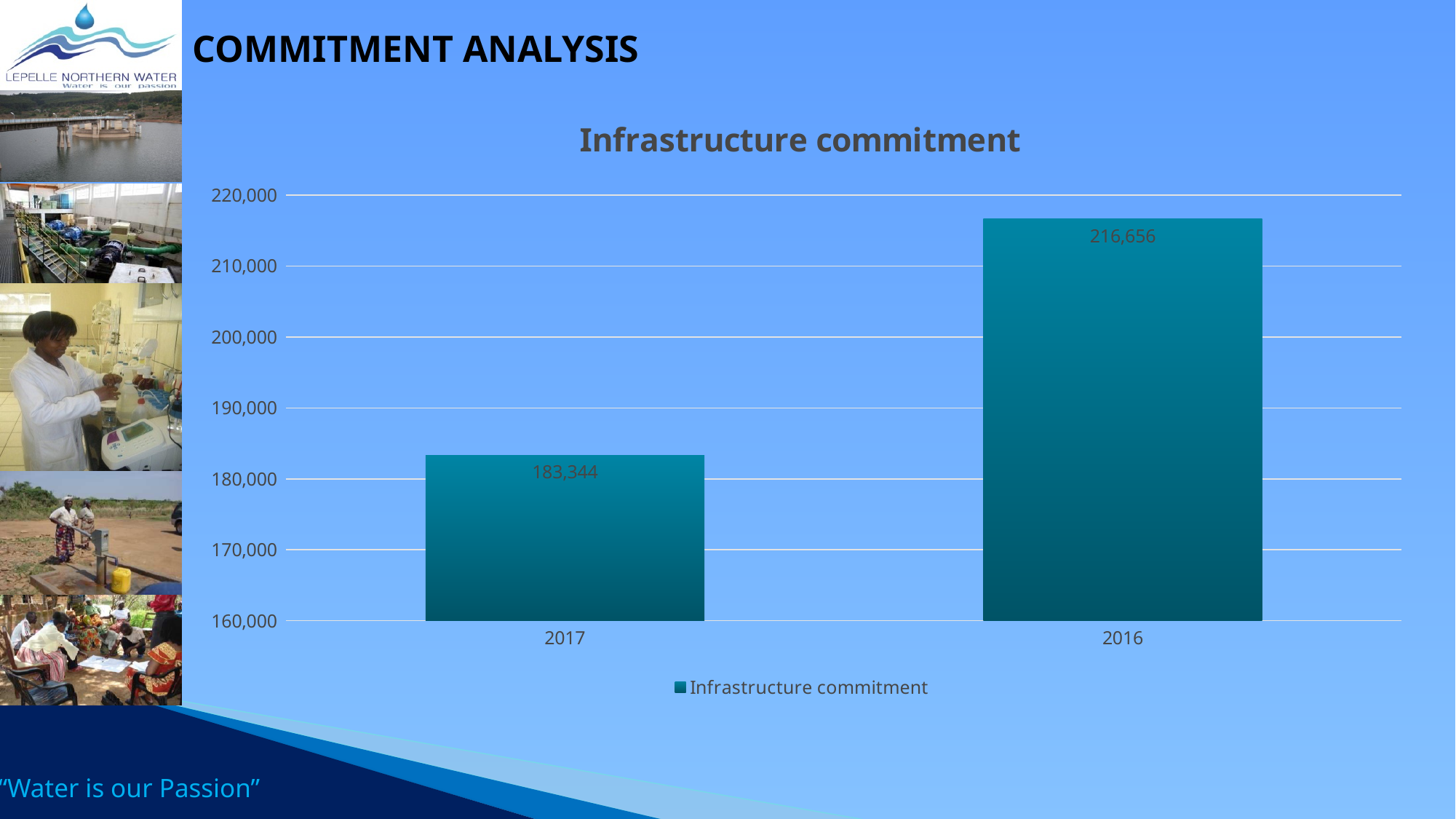
What is the title of the chart? Infrastructure commitment What is the difference between the Infrastructure commitment for 2016 and 2017? 33,312 What is the Infrastructure commitment value for 2017? 183,344 How many years are shown on the chart? 2 Is the Infrastructure commitment for 2016 greater or less than 210,000? greater Is the Infrastructure commitment for 2017 greater or less than 190,000? less Is the Infrastructure commitment larger in 2016 or in 2017? 2016 How many series does the legend list? 1 What is the Infrastructure commitment value for 2016? 216,656 Which year has the higher Infrastructure commitment? 2016 Which year has the lower Infrastructure commitment? 2017 What kind of chart is shown on the slide? bar chart